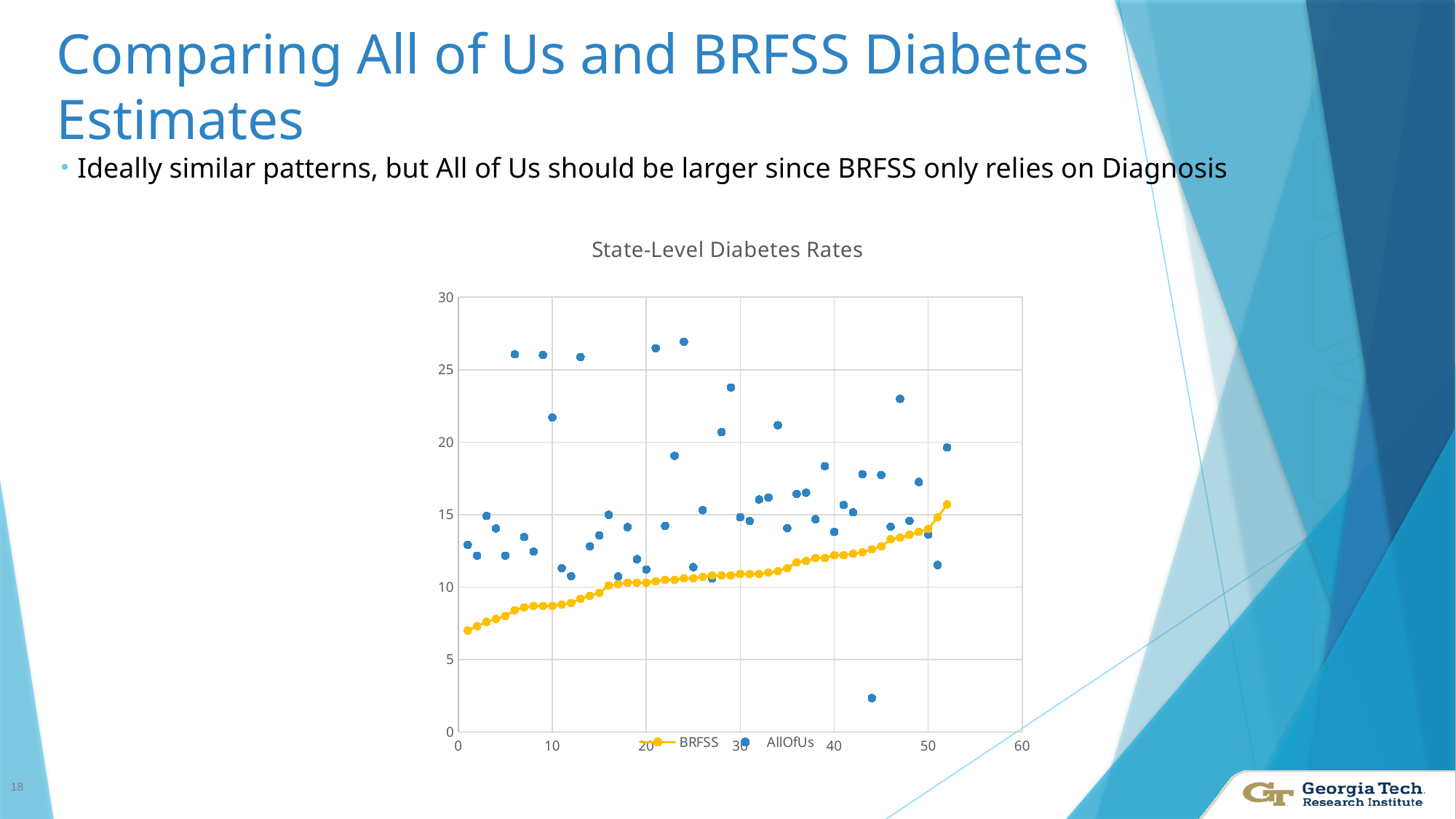
Is the lowest AllOfUs point on the chart greater or less than 5? less What is the maximum value shown on the chart's vertical axis? 30 Is the highest BRFSS value on the chart greater or less than 20? less Is the highest AllOfUs point on the chart greater or less than 25? greater What is the title of the chart? State-Level Diabetes Rates Which series contains the lowest value plotted on the chart? AllOfUs What kind of chart is shown on the slide? Scatter chart How many series does the chart's legend list? 2 Which two series are listed in the chart's legend? BRFSS and AllOfUs Which series reaches the higher maximum value, BRFSS or AllOfUs? AllOfUs Do the BRFSS values rise or fall as you move left to right along the x axis? Rise